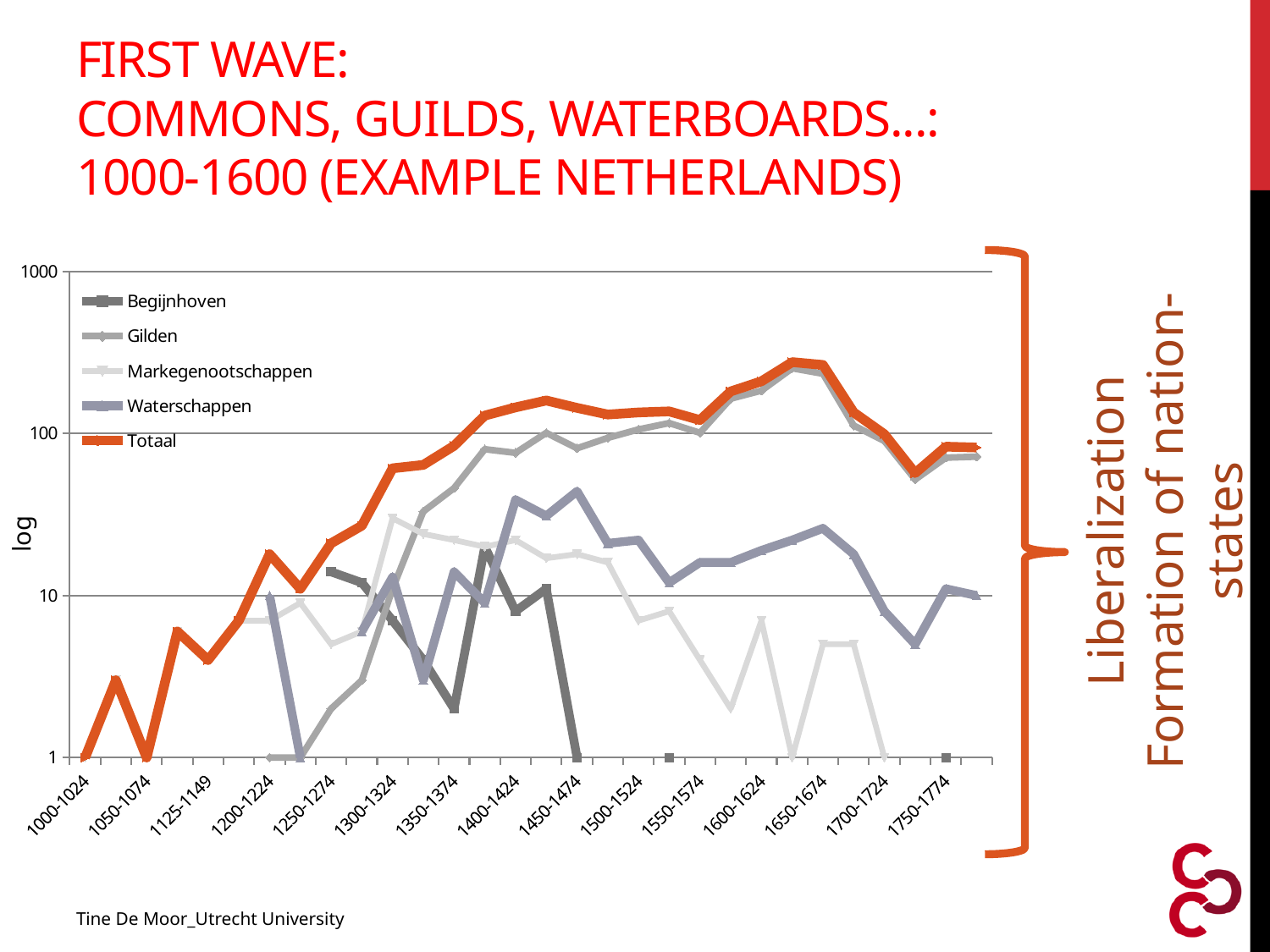
Which series is drawn in orange? Totaal How many period labels are shown on the x axis? 15 What kind of chart is shown on the slide? line chart How many series does the legend list? 5 Which series has the highest value at 1650-1674? Totaal Is the value of Totaal for 1650-1674 greater or less than 100? greater Is the value of Totaal for 1300-1324 greater or less than 10? greater Is the value of Waterschappen for 1650-1674 greater or less than 10? greater Does the Totaal line rise or fall between 1650-1674 and 1700-1724? fall What is the label on the vertical axis? log At 1600-1624, which is larger: Gilden or Markegenootschappen? Gilden